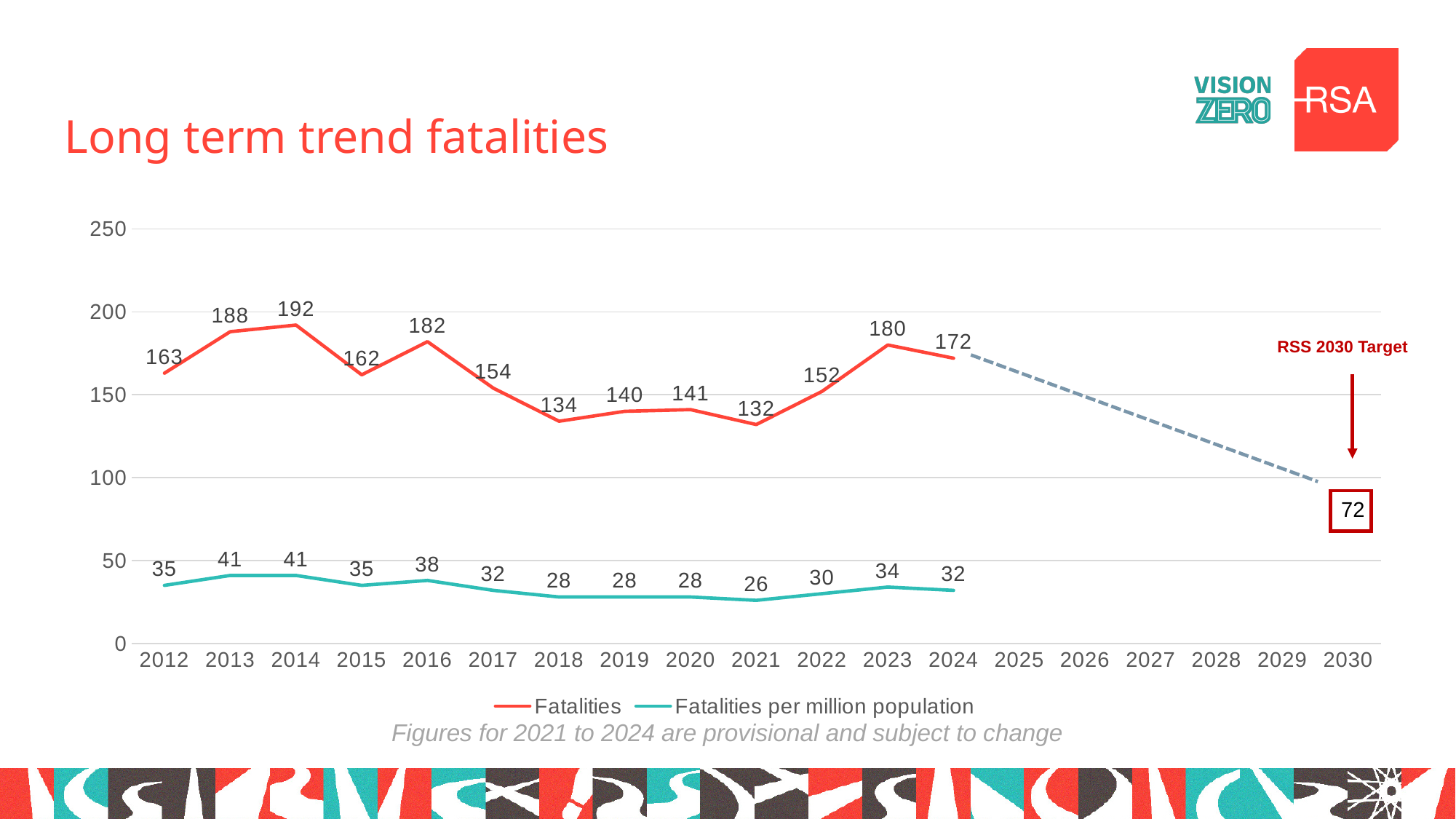
Which is larger, Fatalities in 2016 or Fatalities in 2017? 2016 What is the value of Fatalities in 2014? 192 What is the difference in Fatalities between 2023 and 2024? 8 What is the RSS 2030 Target value shown on the chart? 72 Which year has the highest number of Fatalities? 2014 What is the title of the chart? Long term trend fatalities Is the value of Fatalities in 2018 greater or less than 150? less How many series does the legend list? 2 Do Fatalities rise or fall from 2021 to 2023? rise What is the value of Fatalities per million population in 2021? 26 Which year has the lowest number of Fatalities? 2021 What kind of chart is shown on the slide? line chart